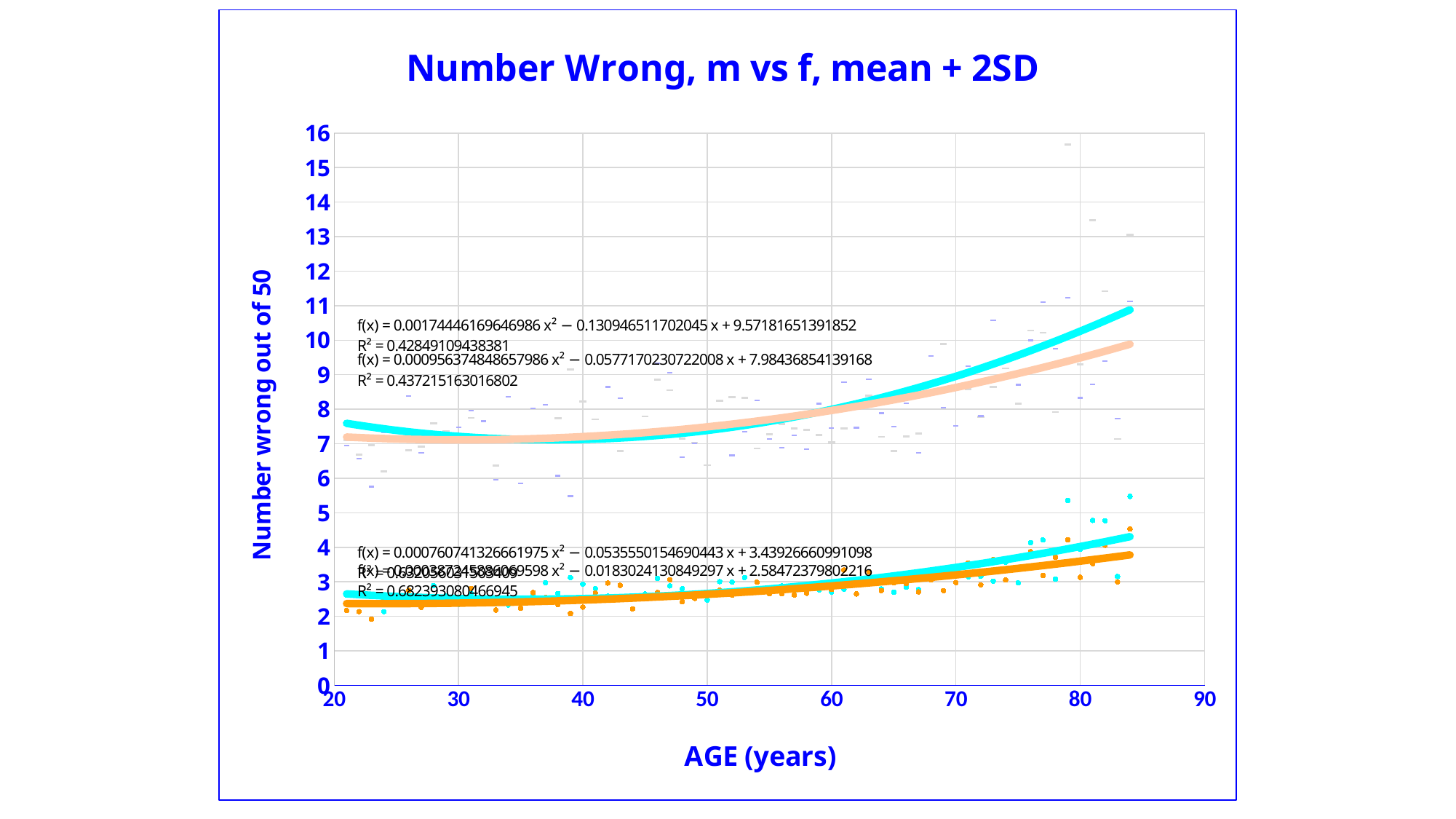
What kind of chart is shown on the slide? Scatter chart At age 84, is the cyan trend line in the upper group greater or less than 10? greater Are the cyan and orange points in the lower group of the chart greater or less than 6? less What is the highest value shown on the y axis of the chart? 16 Is the highest plotted point on the chart (near age 79) greater or less than 15? greater What is the R² value printed for the first (topmost) equation on the chart? 0.42849109438381 What is the R² value printed for the second equation on the chart (the one starting f(x) = 0.000956...)? 0.437215163016802 What is the R² value printed at the bottom of the lower block of equations on the chart? 0.682393080466945 Do the fitted trend lines rise or fall as age increases from 50 to 80? Rise What is the lowest age value shown on the x axis of the chart? 20 What is the label on the x axis of the chart? AGE (years) What is the title of the chart? Number Wrong, m vs f, mean + 2SD